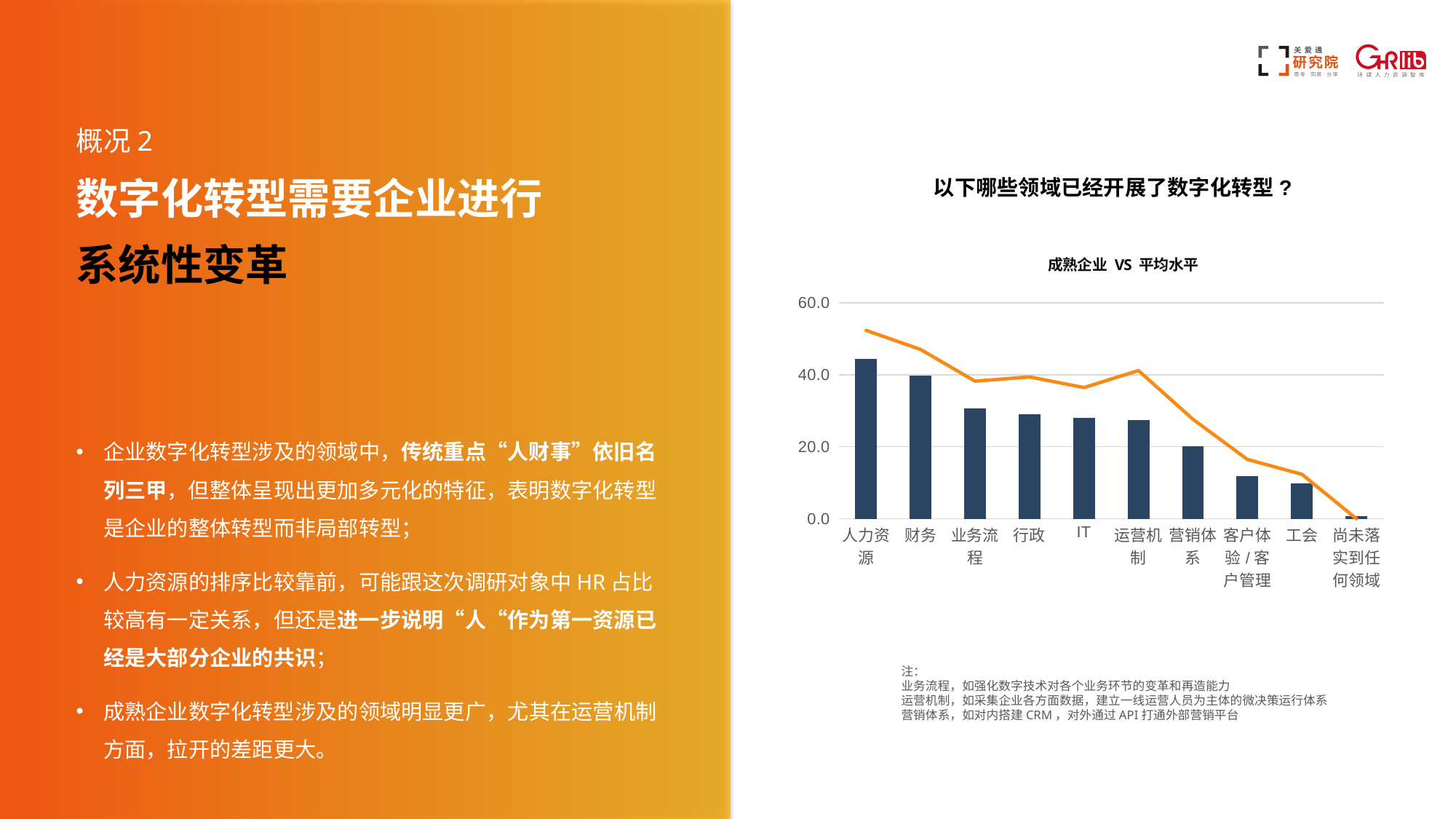
How many categories are shown along the x axis of the chart? 10 Is the bar value for 客户体验/客户管理 greater or less than 20.0? less Is the bar value for 人力资源 greater or less than 40.0? greater Which has the taller bar, 人力资源 or 工会? 人力资源 Which has the taller bar, 业务流程 or 客户体验/客户管理? 业务流程 Which category has the tallest bar in the chart? 人力资源 Is the orange line value for 人力资源 greater or less than 40.0? greater What is the title of the chart? 成熟企业 VS 平均水平 Do the bar values rise or fall from left to right along the x axis? fall Which category has the shortest bar in the chart? 尚未落实到任何领域 What kind of chart is shown on the slide? bar chart with a line overlay